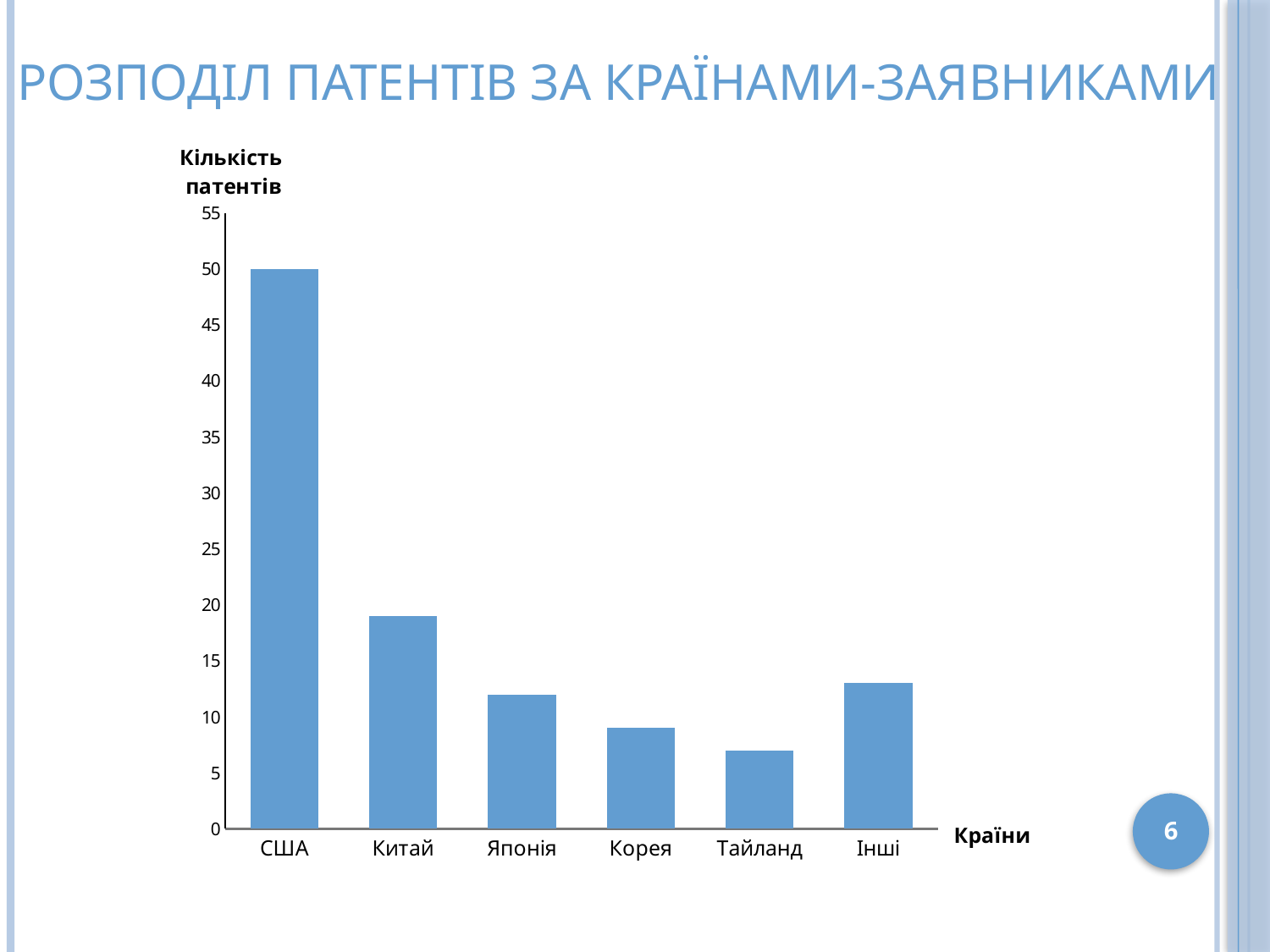
How many countries (categories) are shown on the chart? 6 Is the value for Китай greater or less than 15? greater Which country has the highest number of patents? США Is the value for Тайланд greater or less than 5? greater Is the value for Корея greater or less than 10? less What is the value for США? 50 Which country has the lowest number of patents? Тайланд What kind of chart is shown on the slide? bar chart Which is larger, the value for Китай or the value for Інші? Китай